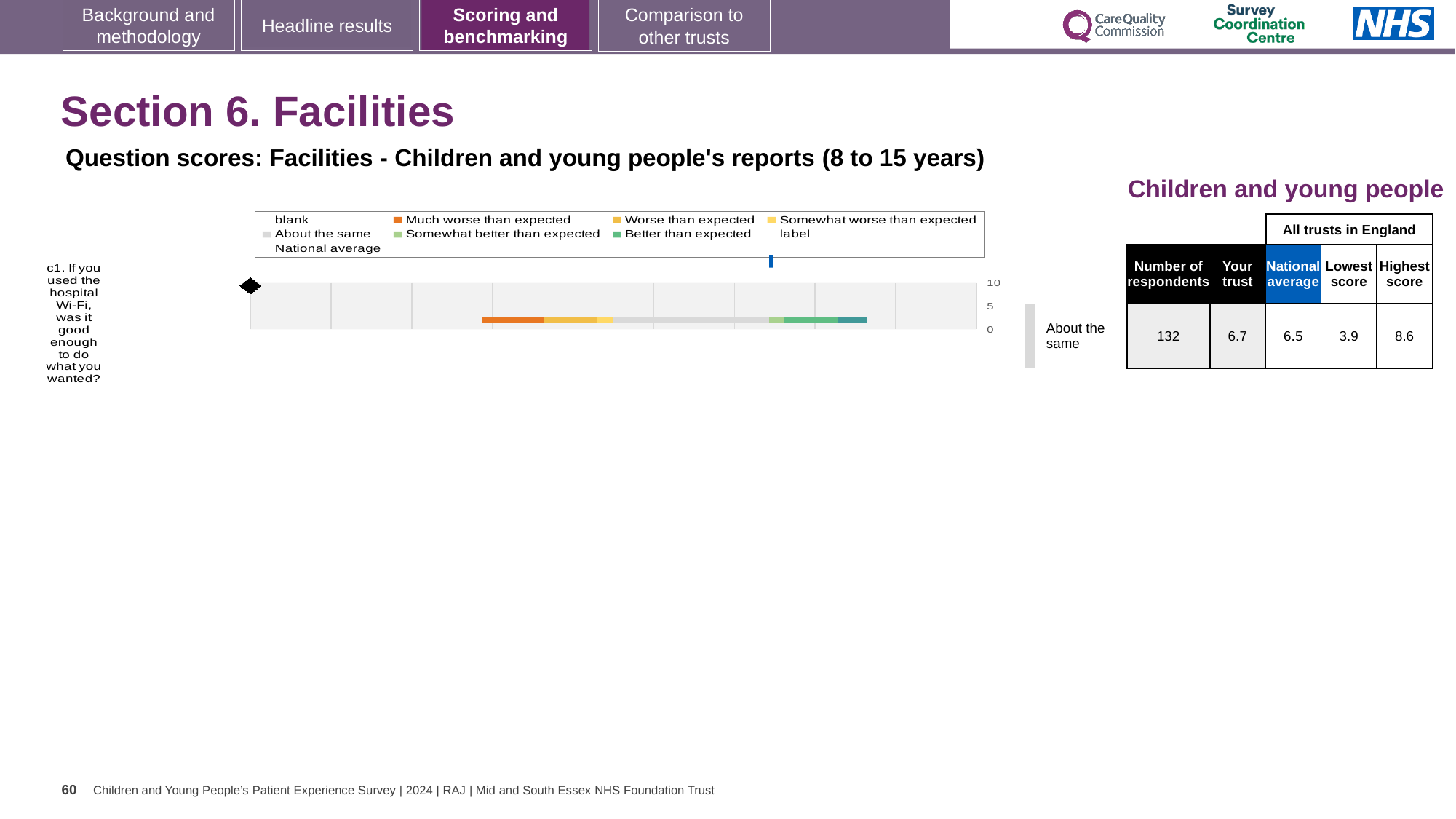
What is the highest tick value shown on the chart's axis? 10 What benchmark category is shown next to the chart for question c1? About the same In the table beside the chart, what is the national average score for question c1? 6.5 In the table beside the chart, what is the lowest score among all trusts in England for question c1? 3.9 How many questions (categories) are plotted in the chart? 1 In the table beside the chart, what is the 'Your trust' score for question c1? 6.7 Which legend entry is shown in orange? Much worse than expected In the table beside the chart, what is the highest score among all trusts in England for question c1? 8.6 What is the difference between the highest score and the lowest score for question c1? 4.7 What kind of chart is shown on the slide? bar chart In the table beside the chart, what is the number of respondents for question c1? 132 Which is larger for question c1: the 'Your trust' score or the national average? Your trust